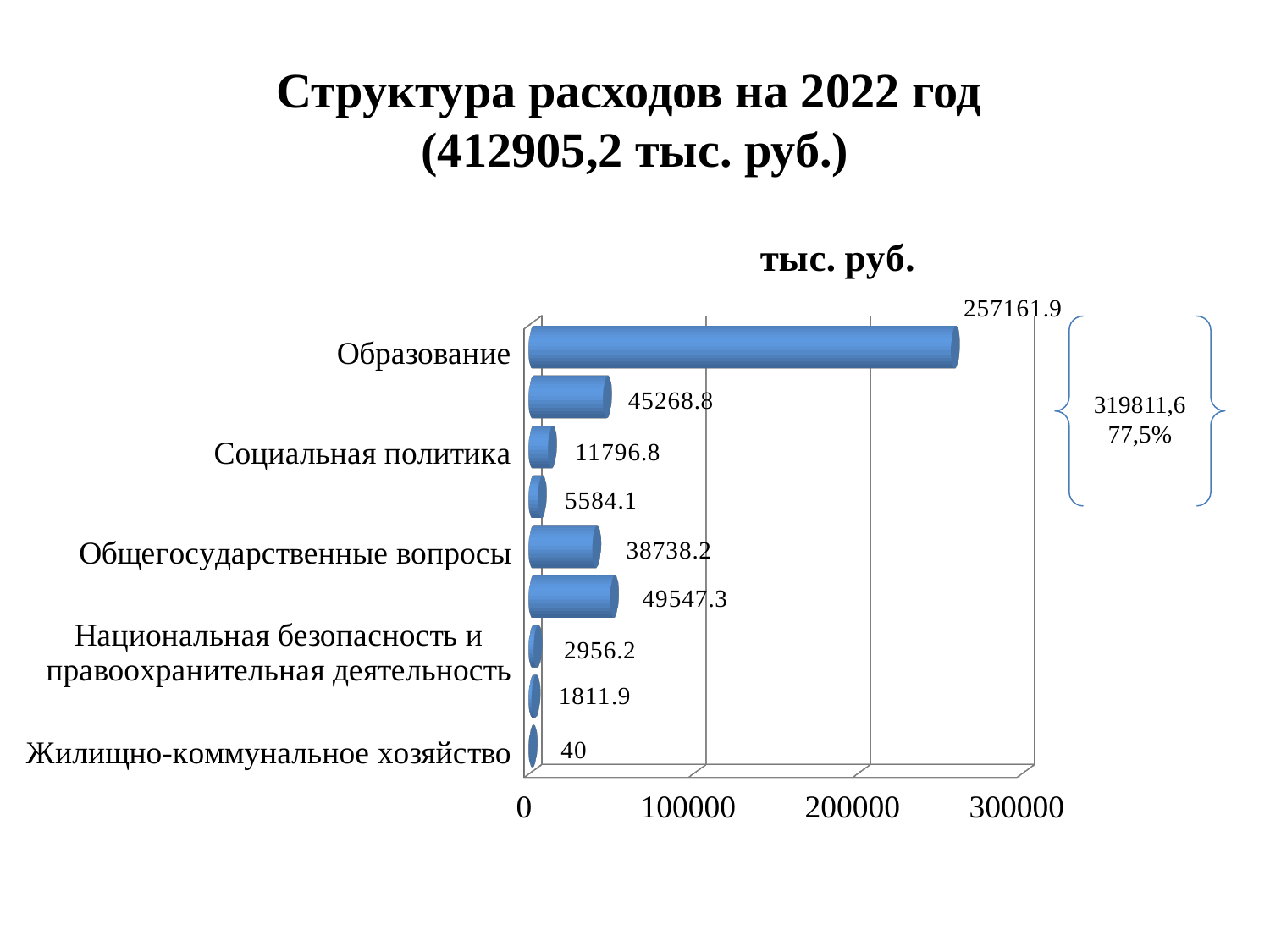
What is the value for Образование? 257161.9 Which category has the highest value? Образование Is the value for Образование greater or less than 200000? greater What unit is given in the chart's title above the plot area? тыс. руб. What is the value for Общегосударственные вопросы? 38738.2 What is the value for Социальная политика? 11796.8 Which category has the lowest value? Жилищно-коммунальное хозяйство What kind of chart is shown on the slide? bar chart What is the value for Национальная безопасность и правоохранительная деятельность? 2956.2 Which is larger, the value for Общегосударственные вопросы or the value for Социальная политика? Общегосударственные вопросы What is the difference between the values for Образование and Социальная политика? 245365.1 What is the value for Жилищно-коммунальное хозяйство? 40